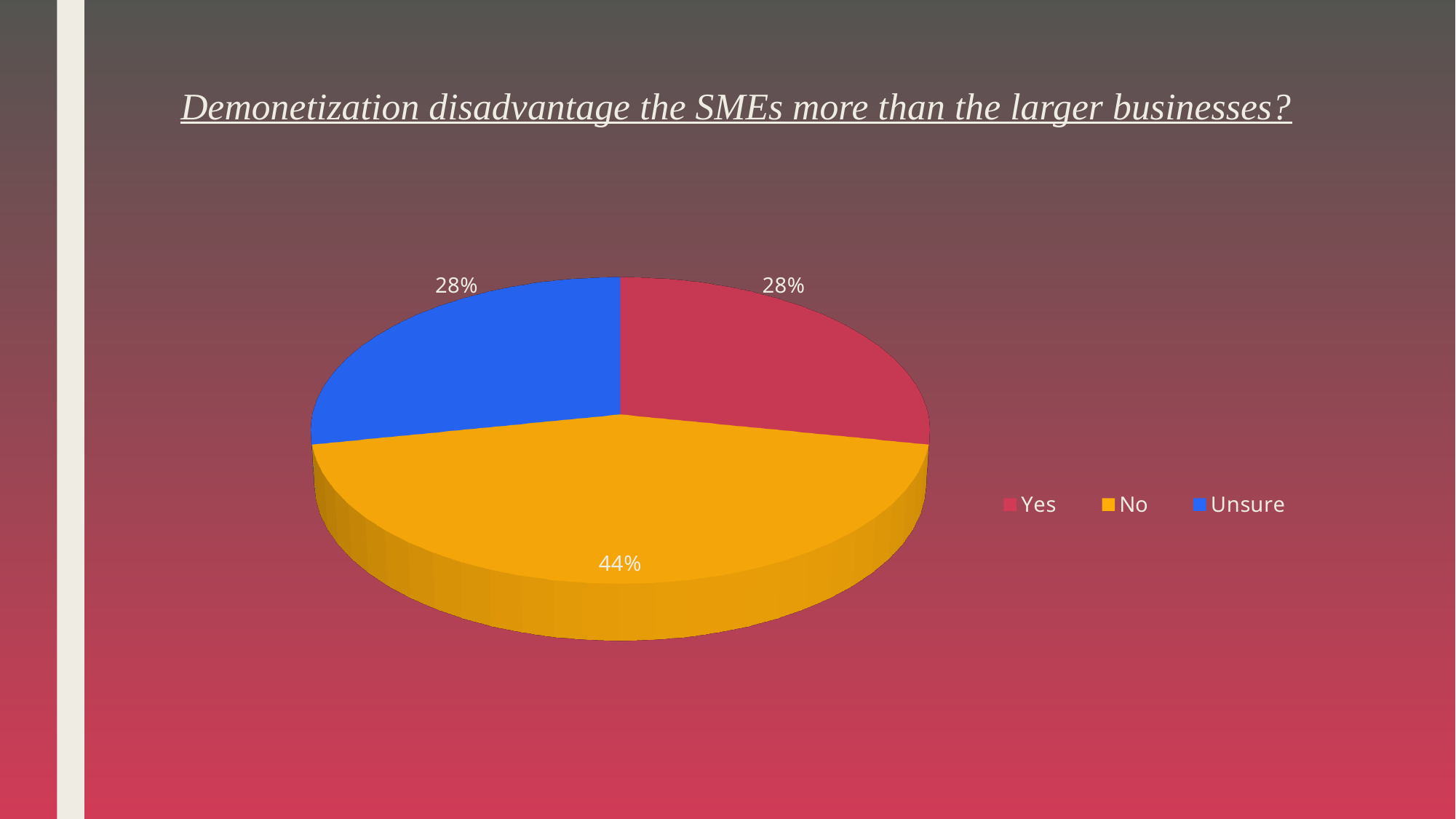
Do the "Yes" and "Unsure" slices have the same percentage? Yes What share of the pie does the "Unsure" slice represent? 28% Which category has the largest slice of the pie? No What is the difference in percentage points between the "No" slice and the "Yes" slice? 16 What is the title of the chart? Demonetization disadvantage the SMEs more than the larger businesses? Which is larger, the "No" slice or the "Unsure" slice? No What kind of chart is shown on the slide? Pie chart What share of the pie does the "Yes" slice represent? 28% What share of the pie does the "No" slice represent? 44% How many categories does the pie chart show? 3 What colour is the "Unsure" slice? Blue